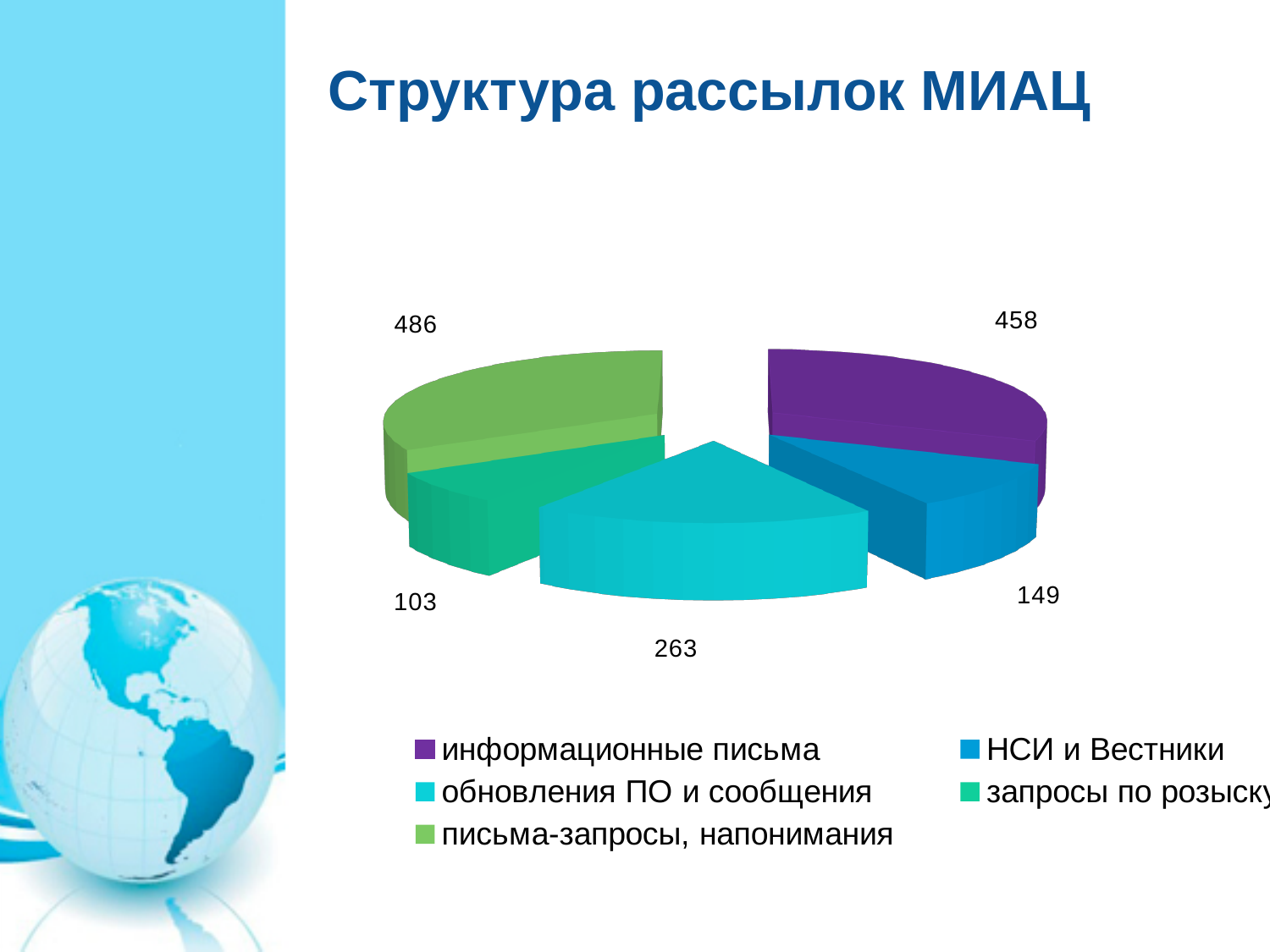
What is the value for обновления ПО и сообщения? 263 What is the value for письма-запросы, напонимания? 486 What is the total of all slices in the pie chart? 1459 What is the title of the chart? Структура рассылок МИАЦ Which category has the largest value? письма-запросы, напонимания Which category has the smallest value? запросы по розыску What is the difference between the values for письма-запросы, напонимания and информационные письма? 28 What is the value for информационные письма? 458 How many slices does the pie chart have? 5 What kind of chart is shown on the slide? pie chart Which is larger: обновления ПО и сообщения or НСИ и Вестники? обновления ПО и сообщения What is the value for НСИ и Вестники? 149